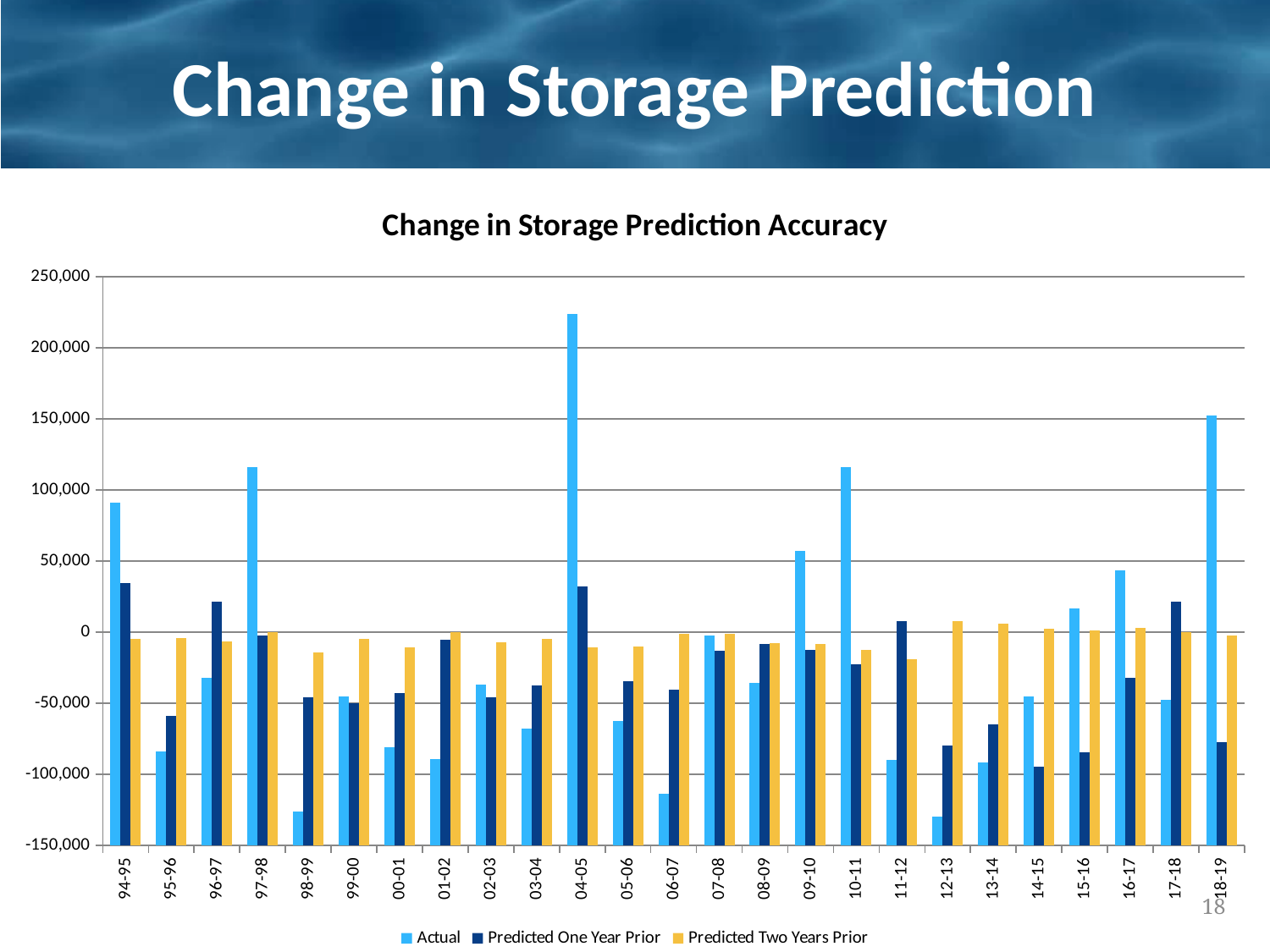
Which is larger, the Actual value for 04-05 or the Actual value for 18-19? 04-05 Is the Predicted One Year Prior value for 14-15 greater or less than -50,000? less What is the title of the chart? Change in Storage Prediction Accuracy Which series is shown in yellow? Predicted Two Years Prior Is the Actual value for 94-95 greater or less than 100,000? less What kind of chart is shown on the slide? Bar chart Is the Actual value for 97-98 greater or less than 100,000? greater Which year has the highest Actual value? 04-05 How many year categories are shown on the x axis? 25 How many series does the legend list? 3